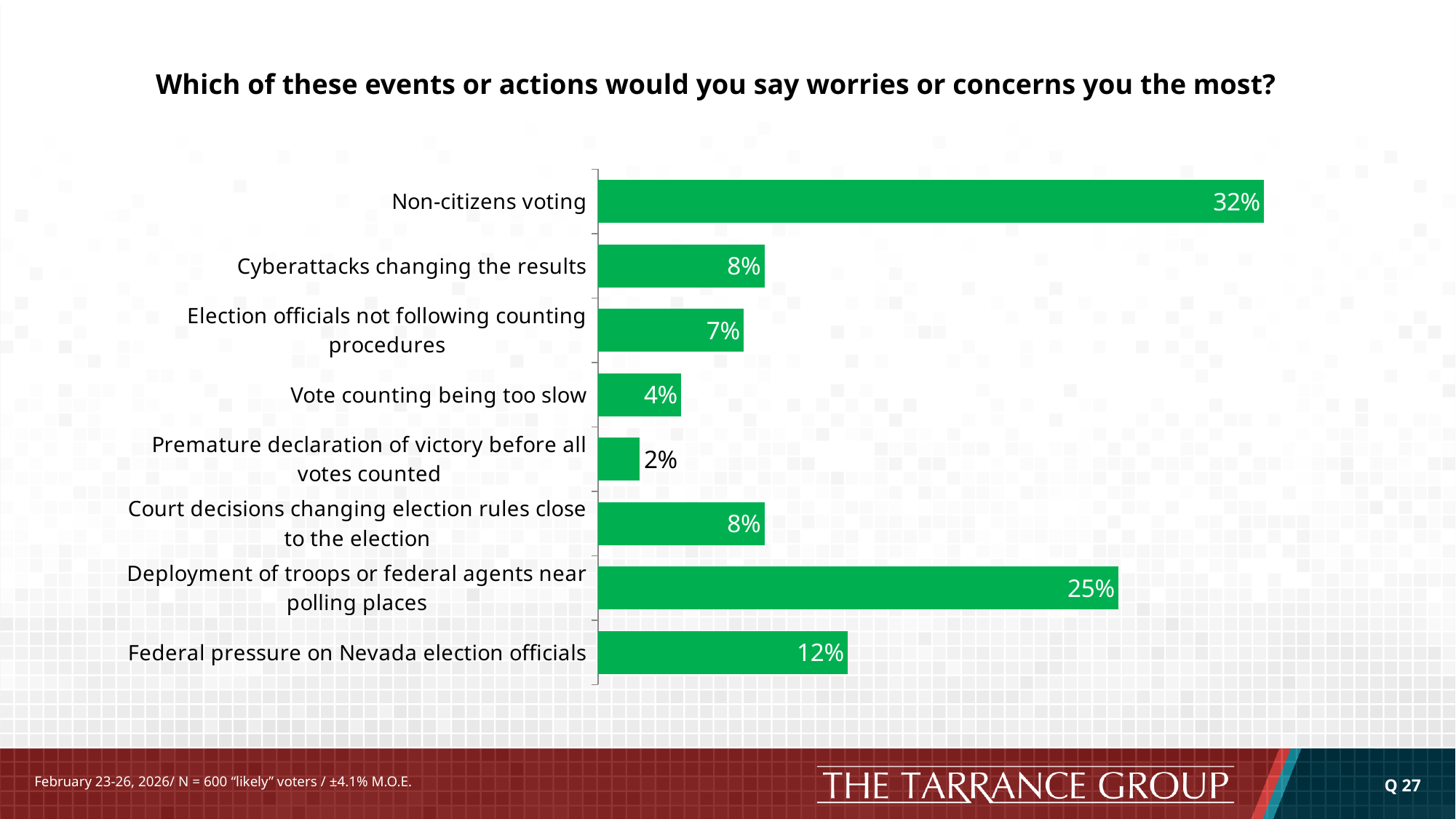
What colour are the bars in the chart? Green What kind of chart is shown on the slide? Bar chart Which category has the highest value? Non-citizens voting What is the value for 'Deployment of troops or federal agents near polling places'? 25% What percentage is shown for 'Federal pressure on Nevada election officials'? 12% What percentage of respondents said non-citizens voting worries them the most? 32% How many categories are shown in the chart? 8 What is the value for 'Vote counting being too slow'? 4% Which category has the lowest value? Premature declaration of victory before all votes counted What is the difference between the values for 'Federal pressure on Nevada election officials' and 'Court decisions changing election rules close to the election'? 4% Which is larger: the value for 'Cyberattacks changing the results' or 'Election officials not following counting procedures'? Cyberattacks changing the results What is the difference between the values for 'Non-citizens voting' and 'Deployment of troops or federal agents near polling places'? 7%